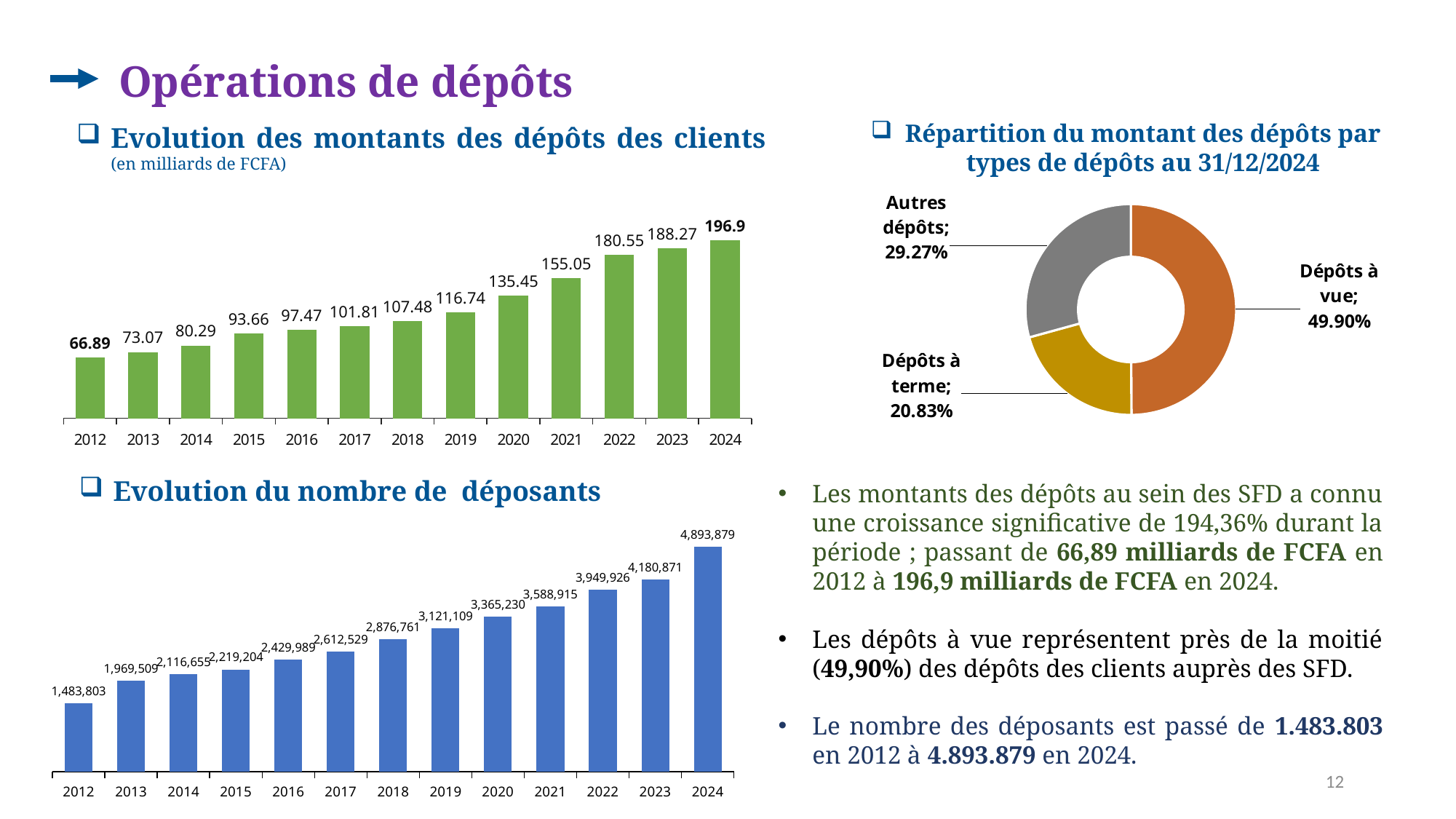
In the chart 'Répartition du montant des dépôts par types de dépôts au 31/12/2024', which type of deposit has the largest share? Dépôts à vue In the chart 'Evolution des montants des dépôts des clients', which year has the lowest value? 2012 In the chart 'Evolution des montants des dépôts des clients', what is the difference between the values for 2024 and 2012? 130.01 In the chart 'Evolution du nombre de déposants', what is the value for 2018? 2,876,761 In the chart 'Evolution du nombre de déposants', which is larger, the value for 2016 or the value for 2019? 2019 In the chart 'Evolution des montants des dépôts des clients', which year has the highest value? 2024 In the chart 'Evolution du nombre de déposants', what is the value for 2023? 4,180,871 In the chart 'Evolution des montants des dépôts des clients', what is the value for 2020? 135.45 In the chart 'Répartition du montant des dépôts par types de dépôts au 31/12/2024', what share do 'Dépôts à terme' represent? 20.83% In the chart 'Evolution des montants des dépôts des clients', how many years are shown on the x axis? 13 In the chart 'Evolution des montants des dépôts des clients', do the values rise or fall from 2012 to 2024? rise What kind of chart is 'Evolution du nombre de déposants'? bar chart